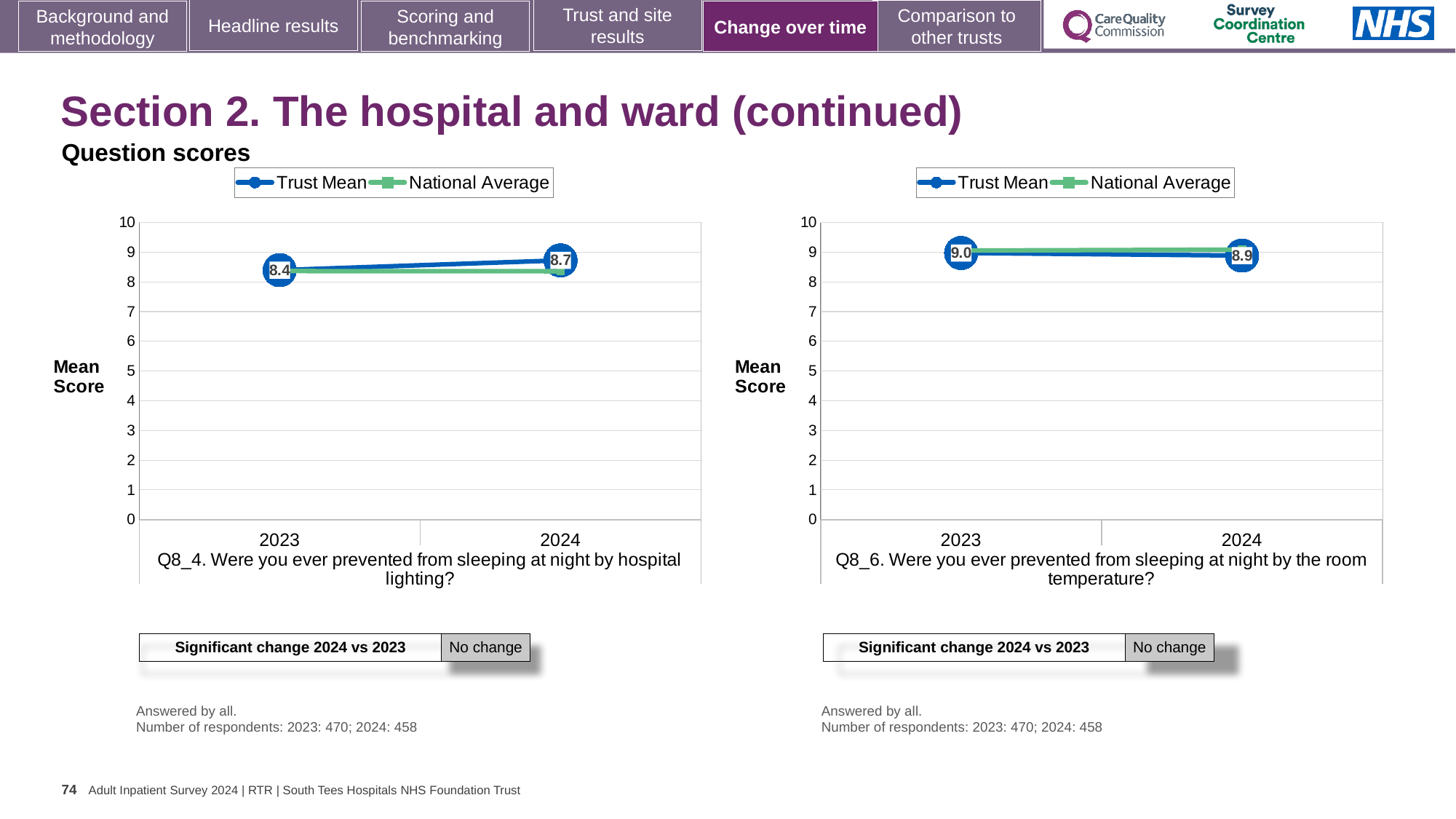
How many years are plotted on the x axis of the left chart (Q8_4)? 2 In the right chart (Q8_6, room temperature), what is the Trust Mean score for 2023? 9.0 In the right chart (Q8_6, room temperature), is the National Average for 2024 greater or less than 8? greater How many series does the legend of the right chart (Q8_6) list? 2 In the right chart (Q8_6, room temperature), what is the difference between the Trust Mean for 2023 and 2024? 0.1 In the right chart (Q8_6, room temperature), does the Trust Mean rise or fall from 2023 to 2024? fall In the left chart (Q8_4, hospital lighting), does the Trust Mean rise or fall from 2023 to 2024? rise In the left chart (Q8_4, hospital lighting), what is the Trust Mean score for 2024? 8.7 In the left chart (Q8_4, hospital lighting), by how much did the Trust Mean change from 2023 to 2024? 0.3 In the left chart (Q8_4, hospital lighting), what is the Trust Mean score for 2023? 8.4 What kind of chart is used for Q8_4 on the left of the slide? line chart In the right chart (Q8_6, room temperature), what is the Trust Mean score for 2024? 8.9